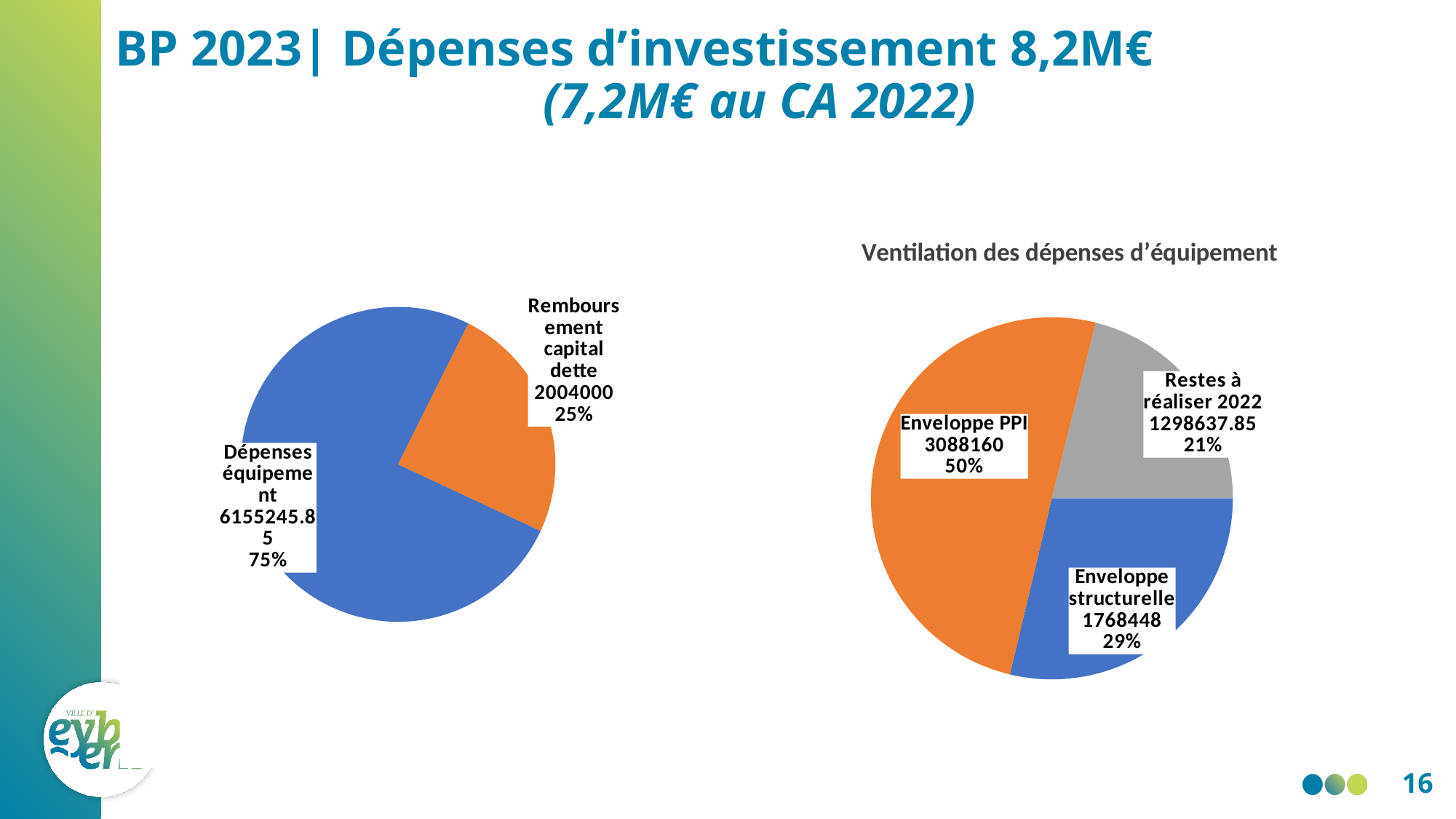
How many slices does the left pie chart have? 2 In the chart titled 'Ventilation des dépenses d'équipement', what is the value for Enveloppe PPI? 3088160 What type of chart is the chart titled 'Ventilation des dépenses d'équipement'? Pie chart In the chart titled 'Ventilation des dépenses d'équipement', what is the value for Enveloppe structurelle? 1768448 In the chart titled 'Ventilation des dépenses d'équipement', which is larger, Enveloppe structurelle or Restes à réaliser 2022? Enveloppe structurelle On the left pie chart, what is the value for Dépenses équipement? 6155245.85 In the chart titled 'Ventilation des dépenses d'équipement', what is the difference between Enveloppe PPI and Enveloppe structurelle? 1319712 On the left pie chart, what is the value for Remboursement capital dette? 2004000 On the left pie chart, what share of the pie is Remboursement capital dette? 25% In the chart titled 'Ventilation des dépenses d'équipement', what share of the pie is Restes à réaliser 2022? 21% In the chart titled 'Ventilation des dépenses d'équipement', which slice is the smallest? Restes à réaliser 2022 On the left pie chart, which slice is the largest? Dépenses équipement